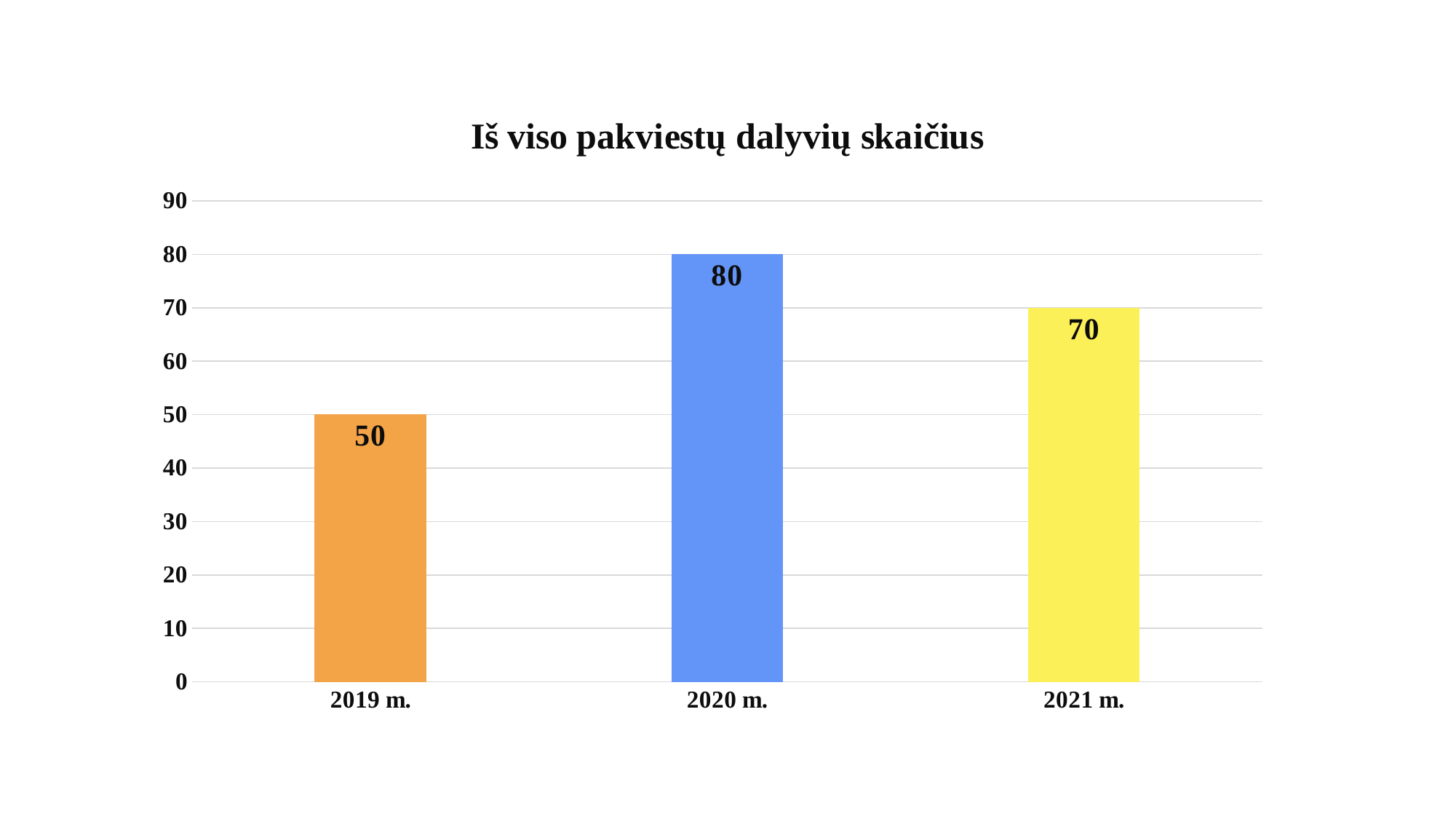
What is the value for 2019 m.? 50 Which year has the lowest value? 2019 m. Is the value for 2021 m. greater or less than 60? greater What is the difference between the values for 2020 m. and 2021 m.? 10 How many years are shown on the chart? 3 Which year has the highest value? 2020 m. What is the difference between the values for 2020 m. and 2019 m.? 30 What is the value for 2020 m.? 80 Which is larger, the value for 2021 m. or the value for 2019 m.? 2021 m. What kind of chart is shown on the slide? bar chart What is the value for 2021 m.? 70 What is the title of the chart? Iš viso pakviestų dalyvių skaičius